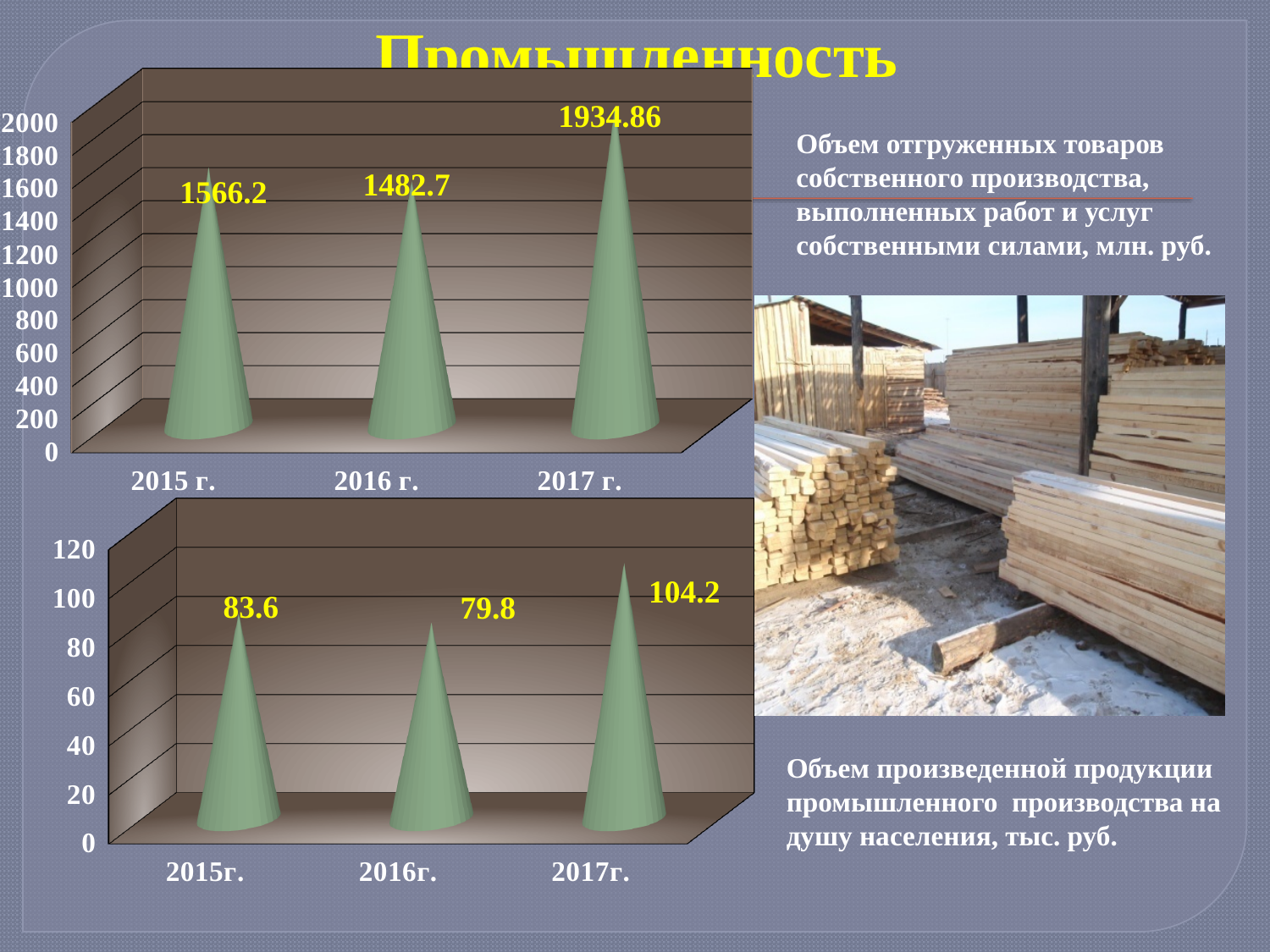
In the bottom chart, what is the value for 2015г.? 83.6 What kind of chart is the bottom chart? bar chart In the bottom chart, which year has the lowest value? 2016г. In the bottom chart, what is the value for 2017г.? 104.2 In the bottom chart, what is the difference between the values for 2017г. and 2016г.? 24.4 In the top chart, what is the value for 2016 г.? 1482.7 In the bottom chart, how many years are plotted? 3 In the top chart, what is the difference between the values for 2017 г. and 2015 г.? 368.66 In the top chart, is the value for 2015 г. greater or less than 1400? greater In the top chart, which year has the lowest value? 2016 г. In the top chart, what is the value for 2017 г.? 1934.86 In the top chart, which year has the highest value? 2017 г.